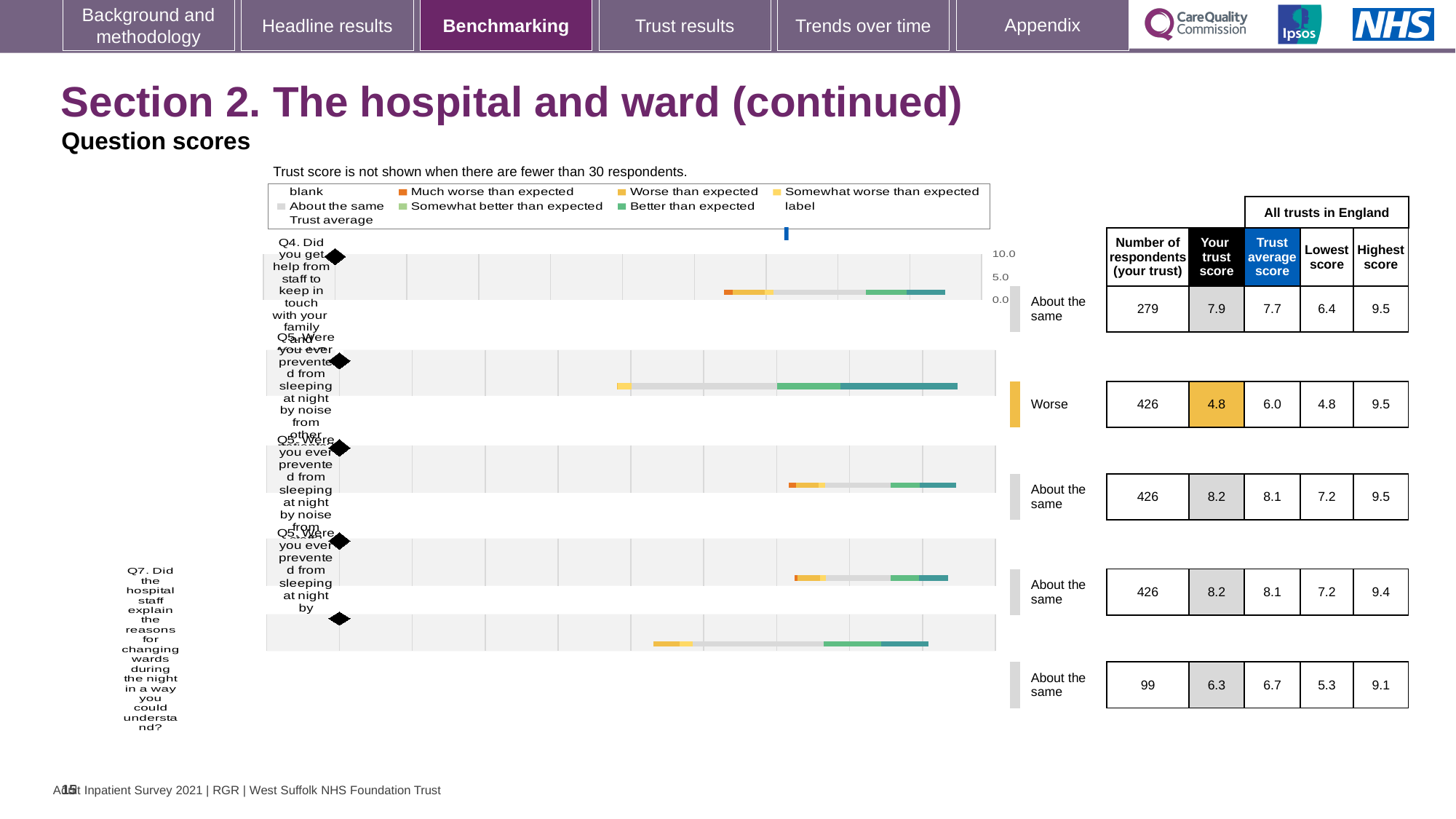
What is the maximum value shown on the chart's score axis? 10.0 For the Q7 row, what is the difference between the highest score (9.1) and the lowest score (5.3)? 3.8 In the table beside the chart, what is 'Your trust score' for the row rated 'Worse'? 4.8 In the table beside the chart, what is the highest score for the Q7 row (explaining reasons for changing wards during the night)? 9.1 How many question rows (bars) are plotted in the chart? 5 Which row in the table has the lowest 'Your trust score'? the row rated 'Worse' (4.8) For the Q4 row, which is larger: your trust score or the trust average score? your trust score For the Q4 row, what is the difference between your trust score (7.9) and the trust average score (7.7)? 0.2 In the table beside the chart, what is the number of respondents for the Q4 row (help from staff to keep in touch with family and friends)? 279 What kind of chart is used to show the question scores on this slide? bar chart How many of the chart rows are labelled 'Worse' rather than 'About the same'? 1 In the table beside the chart, what is the trust average score for the Q4 row? 7.7